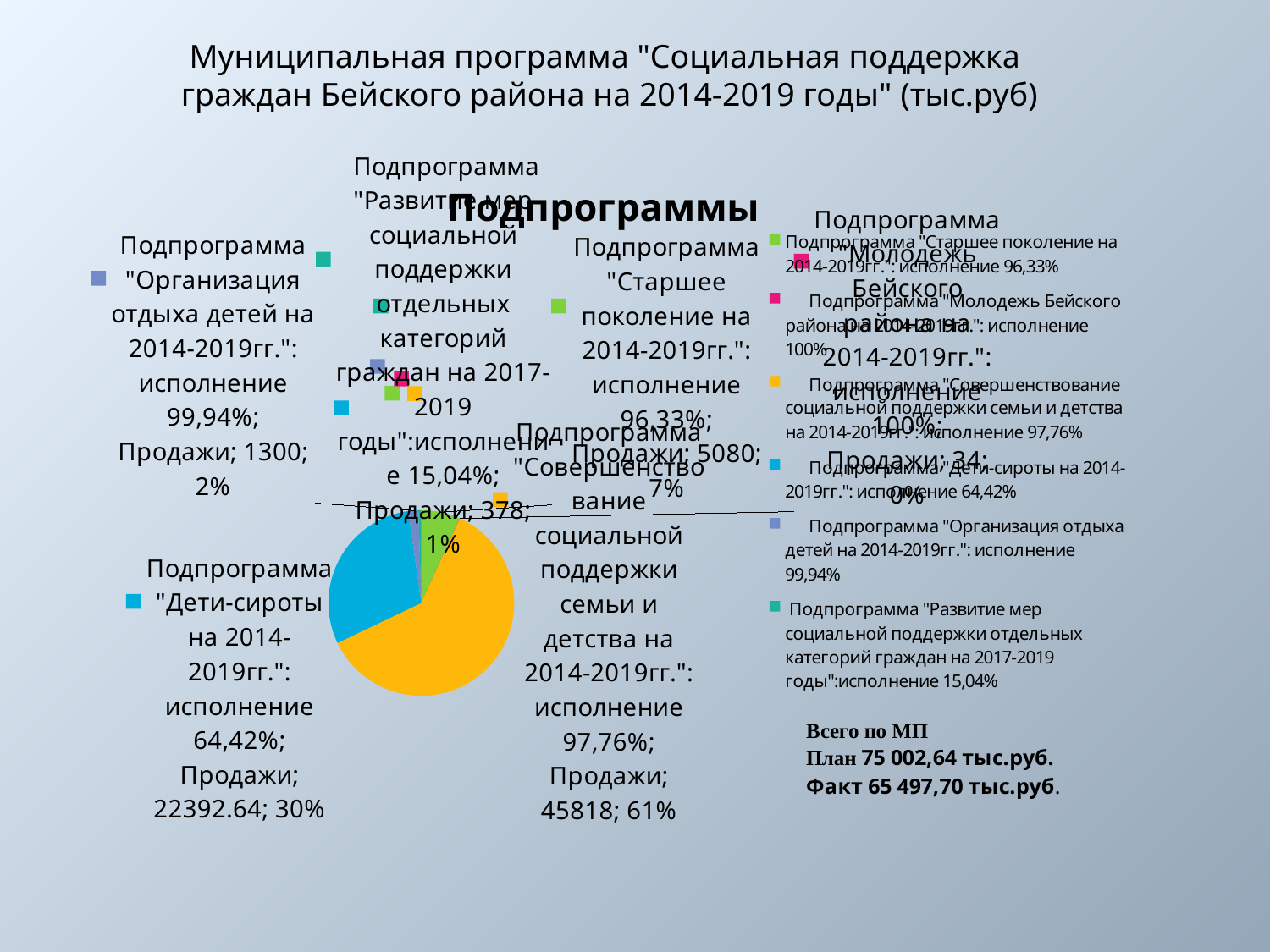
Which subprogram has the largest slice of the pie? Подпрограмма "Совершенствование социальной поддержки семьи и детства на 2014-2019гг." What is the value shown for the subprogram "Организация отдыха детей на 2014-2019гг."? 1300 Which is larger: the value for "Дети-сироты на 2014-2019гг." or the value for "Старшее поколение на 2014-2019гг."? Дети-сироты на 2014-2019гг. How many entries does the chart legend list? 6 What is the difference between the value for "Совершенствование социальной поддержки семьи и детства на 2014-2019гг." (45818) and the value for "Дети-сироты на 2014-2019гг." (22392.64)? 23425.36 What share of the pie does the subprogram "Дети-сироты на 2014-2019гг." take? 30% What is the title of the chart? Подпрограммы Which subprogram has the smallest slice of the pie? Подпрограмма "Молодежь Бейского района на 2014-2019гг." What share of the pie does the subprogram "Старшее поколение на 2014-2019гг." take? 7% What is the value shown for the subprogram "Старшее поколение на 2014-2019гг."? 5080 What kind of chart is shown on the slide? pie chart How many slices does the pie chart have? 6